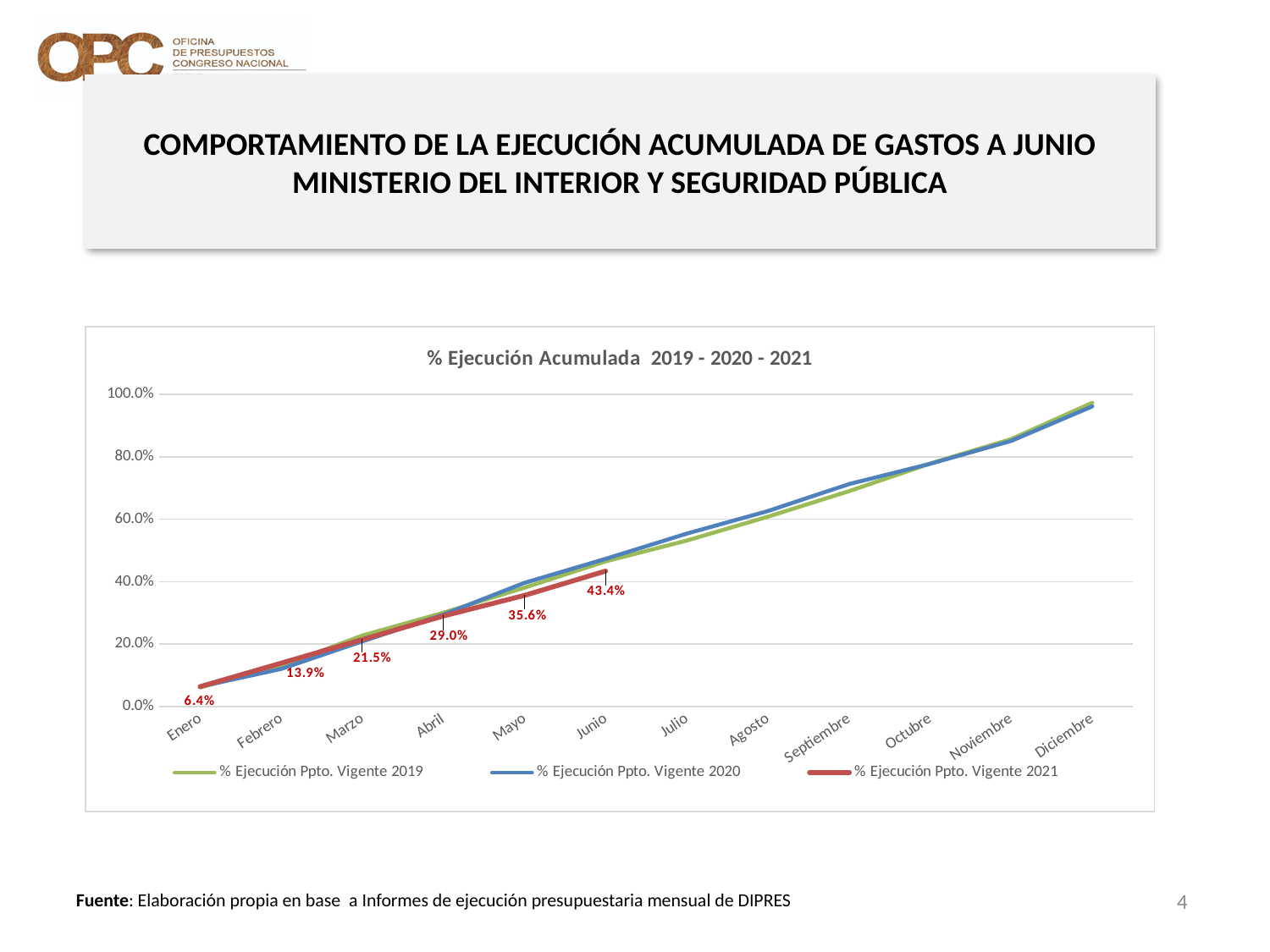
What is the value of % Ejecución Ppto. Vigente 2021 for Enero? 6.4% How many months are shown on the x axis? 12 Do the values of % Ejecución Ppto. Vigente 2019 rise or fall from Enero to Diciembre? Rise What kind of chart is shown on the slide? Line chart Is the value for % Ejecución Ppto. Vigente 2020 in Diciembre greater or less than 80.0%? greater What is the difference between the 2021 values for Junio and Enero? 37.0 percentage points Which month has the highest value for % Ejecución Ppto. Vigente 2021? Junio What is the value of % Ejecución Ppto. Vigente 2021 for Junio? 43.4% What is the value of % Ejecución Ppto. Vigente 2021 for Abril? 29.0% How many series does the legend list? 3 What is the value of % Ejecución Ppto. Vigente 2021 for Mayo? 35.6% What is the difference between the 2021 values for Marzo and Febrero? 7.6 percentage points